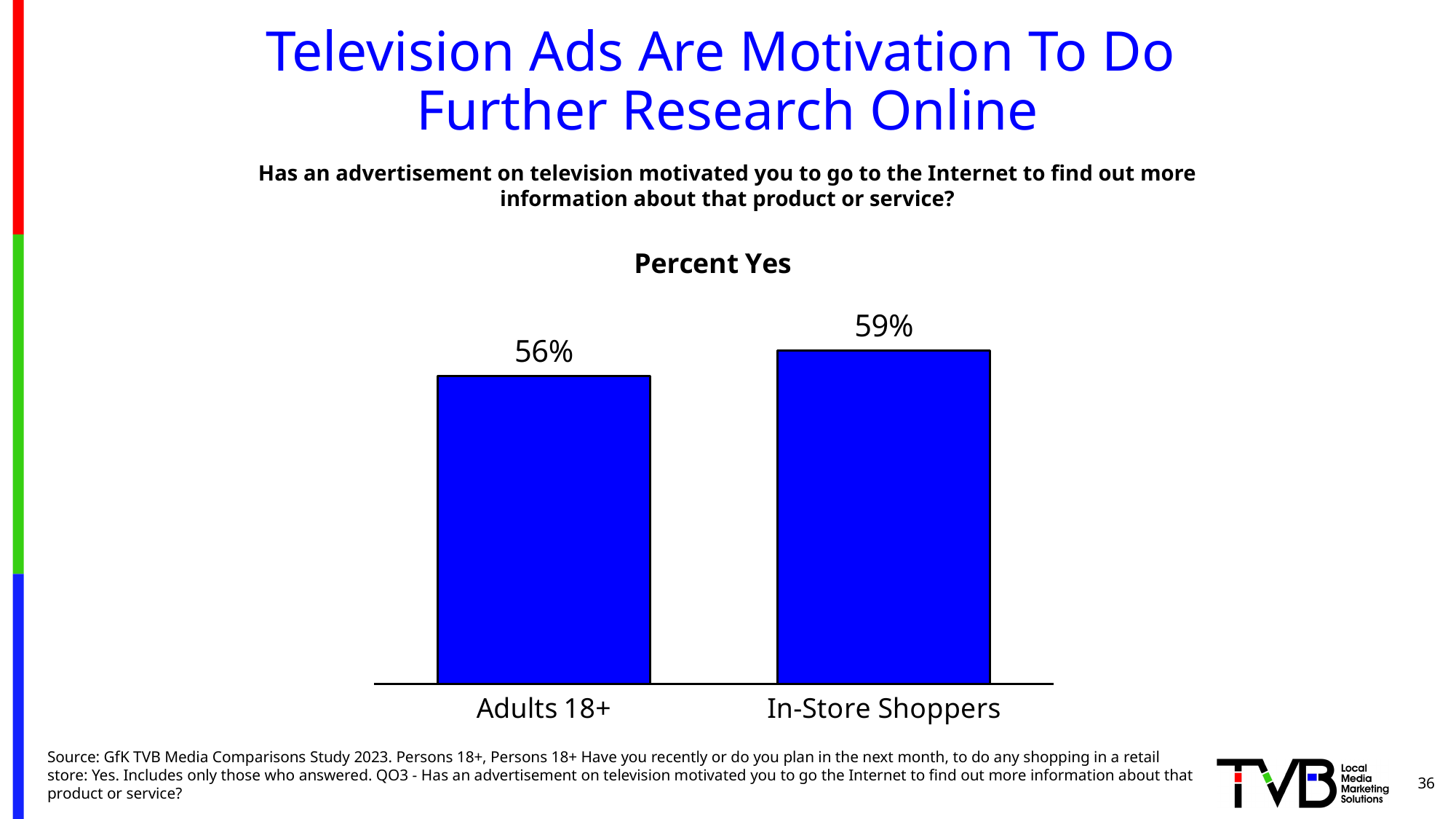
What kind of chart is shown on the slide? Bar chart What is the Percent Yes value for Adults 18+? 56% How many categories are shown in the chart? 2 What is the difference in Percent Yes between In-Store Shoppers and Adults 18+? 3% Which is larger, the Percent Yes for Adults 18+ or for In-Store Shoppers? In-Store Shoppers What colour are the bars in the chart? Blue What is the title of the chart? Percent Yes Which category has the highest Percent Yes value? In-Store Shoppers What is the Percent Yes value for In-Store Shoppers? 59% Which category has the lowest Percent Yes value? Adults 18+